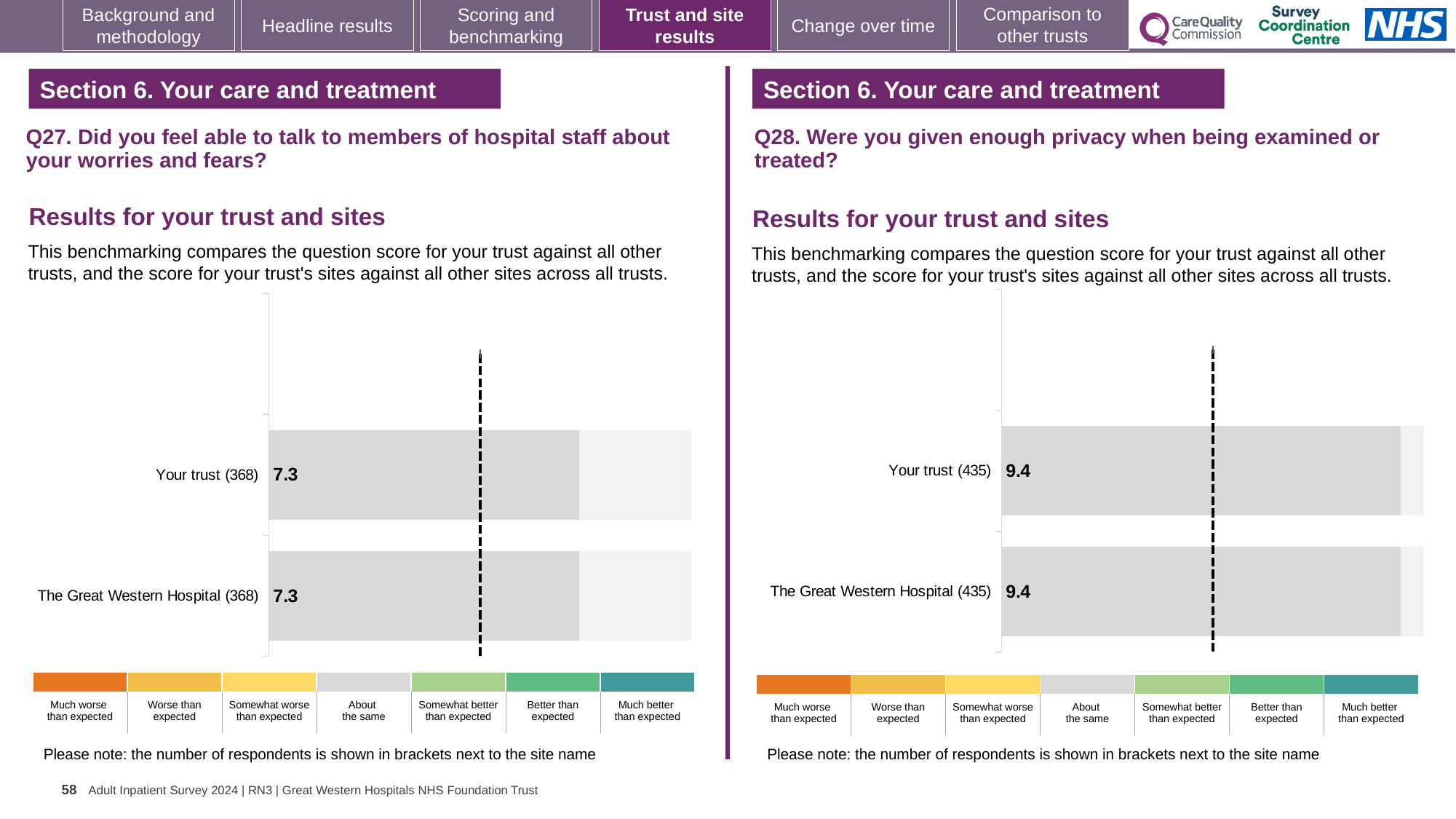
On the Q27 chart (left), what is the difference between the score for Your trust and the score for The Great Western Hospital? 0 On the Q27 chart (left), what is the score for Your trust? 7.3 How many bars are plotted on the Q27 chart (left)? 2 On the Q27 chart (left), how many respondents are shown in brackets next to Your trust? 368 On the Q28 chart (right), what is the difference between the score for Your trust and the score for The Great Western Hospital? 0 What kind of chart is the Q27 chart (left)? Bar chart On the Q28 chart (right), what is the score for The Great Western Hospital? 9.4 How many bars are plotted on the Q28 chart (right)? 2 On the Q28 chart (right), how many respondents are shown in brackets next to The Great Western Hospital? 435 On the Q27 chart (left), what is the score for The Great Western Hospital? 7.3 Is the score for Your trust on the Q28 chart (right) larger or smaller than the score for Your trust on the Q27 chart (left)? Larger On the Q28 chart (right), what is the score for Your trust? 9.4